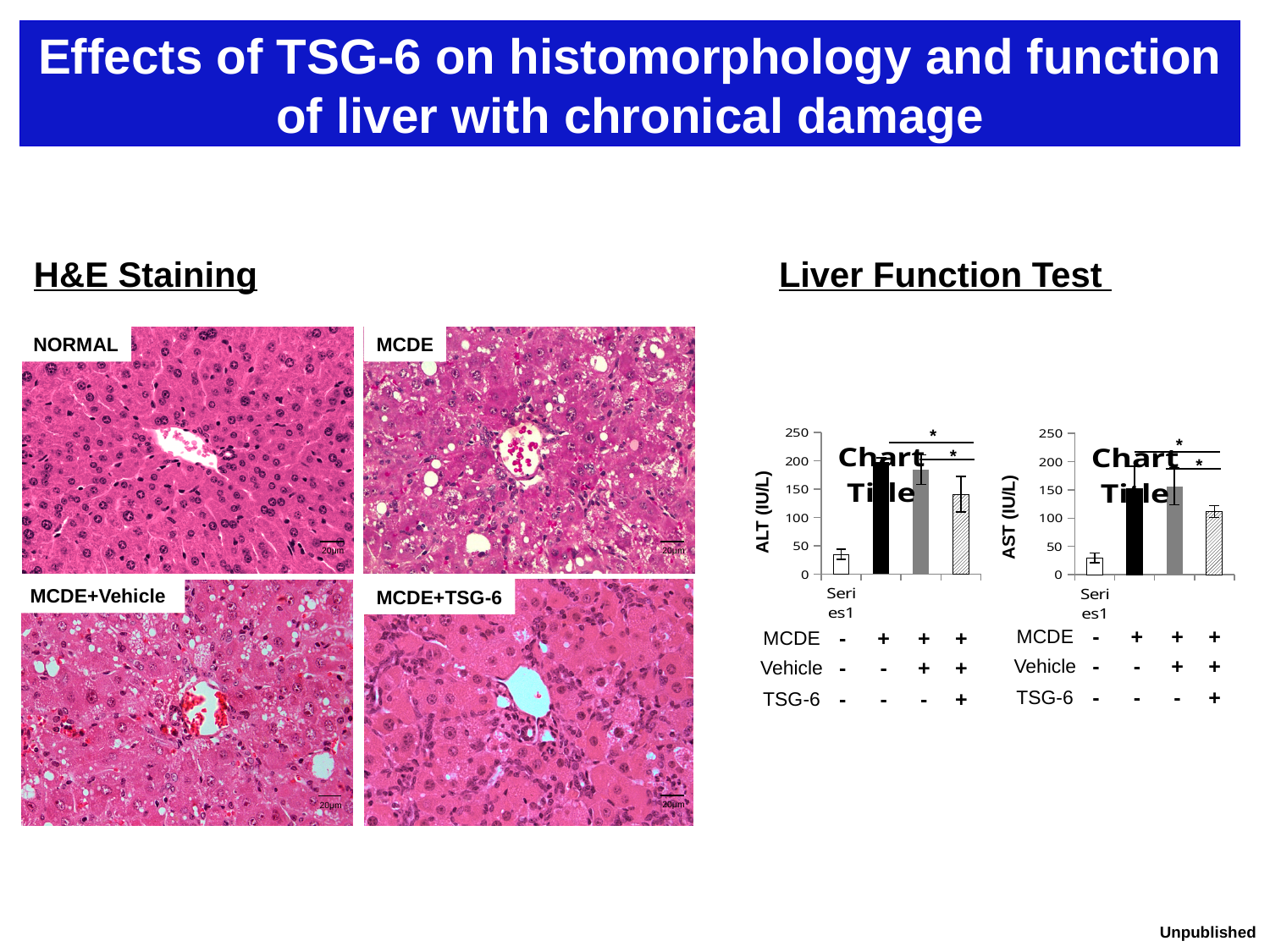
In the AST (IU/L) chart, which is larger: the gray bar (MCDE + Vehicle) or the hatched bar (MCDE + Vehicle + TSG-6)? the gray bar (MCDE + Vehicle) What kind of chart is the ALT (IU/L) chart? bar chart In the ALT (IU/L) chart, is the value for the black bar (MCDE only) greater or less than 150? greater How many bars are plotted in the AST (IU/L) chart? 4 In the ALT (IU/L) chart, which is larger: the black bar (MCDE only) or the hatched bar (MCDE + Vehicle + TSG-6)? the black bar (MCDE only) In the ALT (IU/L) chart, which bar is the tallest? the black bar (MCDE only) In the ALT (IU/L) chart, is the value for the white bar (untreated control) greater or less than 50? less In the AST (IU/L) chart, which bar is the shortest? the white bar (no MCDE, no Vehicle, no TSG-6) In the AST (IU/L) chart, is the value for the black bar (MCDE only) greater or less than 100? greater What is the highest tick value shown on the y-axis of the AST (IU/L) chart? 250 What is the y-axis label of the left chart under Liver Function Test? ALT (IU/L)